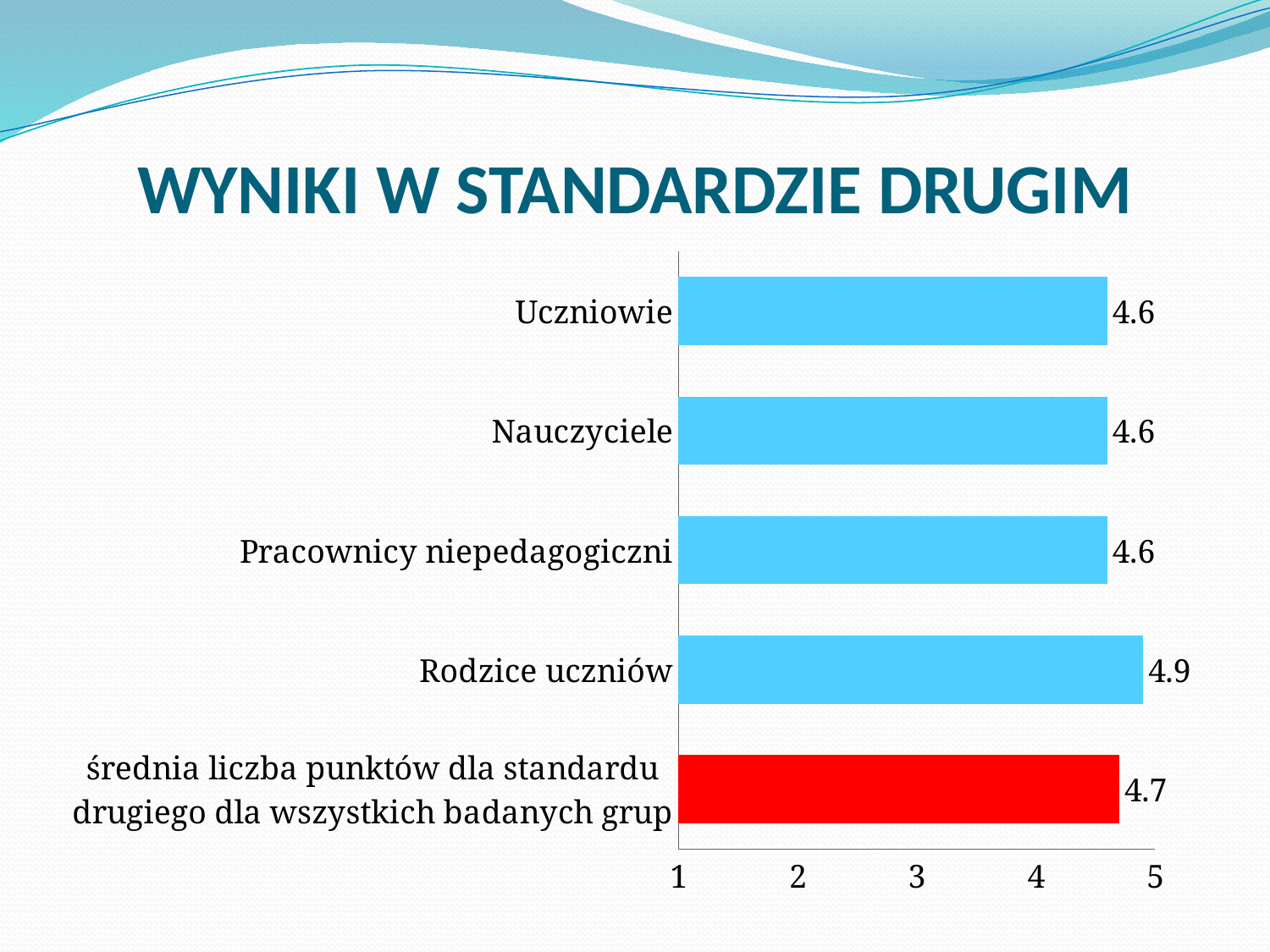
What is the value for the red bar, średnia liczba punktów dla standardu drugiego dla wszystkich badanych grup? 4.7 What is the value for Pracownicy niepedagogiczni? 4.6 What is the title of the slide? WYNIKI W STANDARDZIE DRUGIM How many bars are shown in the chart? 5 Which bar is coloured red? średnia liczba punktów dla standardu drugiego dla wszystkich badanych grup Is the value for Uczniowie greater or less than 4? greater What is the value for Nauczyciele? 4.6 What kind of chart is shown on the slide? bar chart What is the difference between the value for Rodzice uczniów and the value for Uczniowie? 0.3 Which is larger, the value for Rodzice uczniów or the value for Nauczyciele? Rodzice uczniów What is the value for Rodzice uczniów? 4.9 Which category has the highest value? Rodzice uczniów